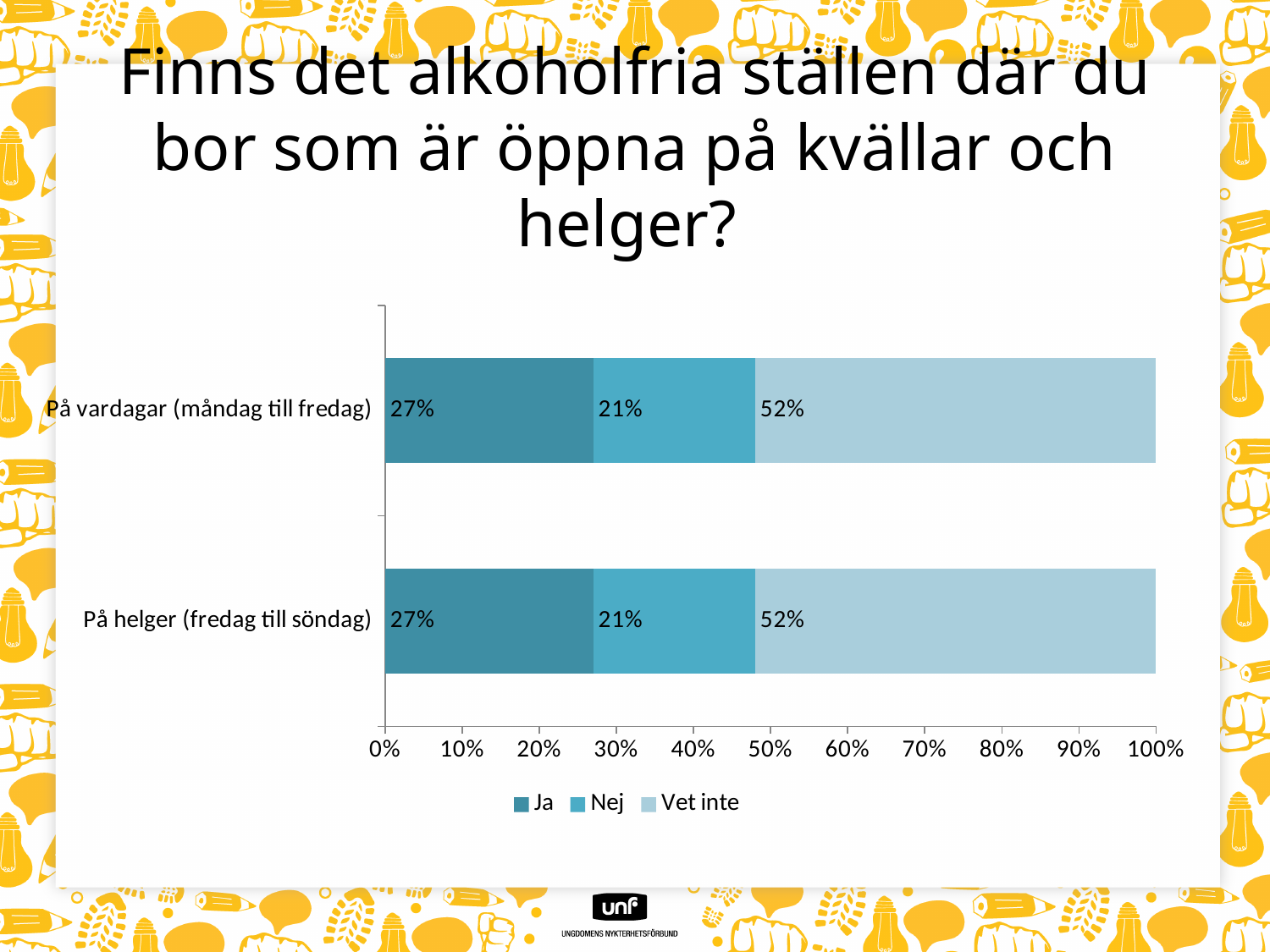
What is the total of the "På vardagar (måndag till fredag)" stacked bar? 100% Which series has the largest share in the "På helger (fredag till söndag)" bar? Vet inte What is the value for "Vet inte" in the "På vardagar (måndag till fredag)" bar? 52% Which series has the smallest share in the "På vardagar (måndag till fredag)" bar? Nej What kind of chart is shown on the slide? stacked bar chart How many categories are plotted on the chart? 2 Is the "Ja" value for "På vardagar (måndag till fredag)" larger or smaller than the "Nej" value for the same category? larger What is the value for "Nej" in the "På helger (fredag till söndag)" bar? 21% What is the value for "Ja" in the "På vardagar (måndag till fredag)" bar? 27% What are the legend entries of the chart? Ja, Nej, Vet inte What is the difference between the "Vet inte" and "Ja" values in the "På helger (fredag till söndag)" bar? 25% How many series does the legend list? 3